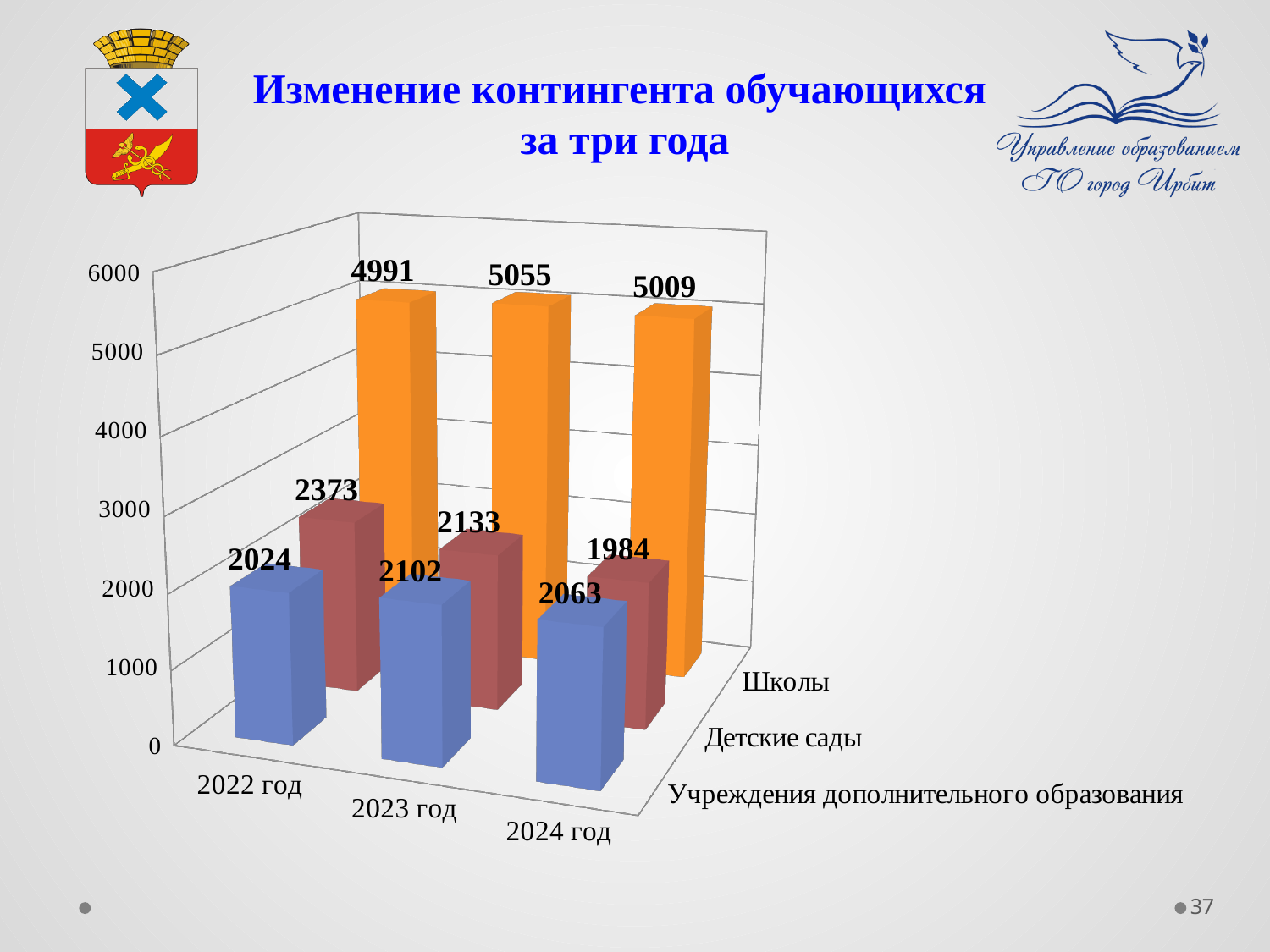
What kind of chart is shown on the slide? bar chart Do the values for Детские сады rise or fall from 2022 год to 2024 год? fall What is the value for Учреждения дополнительного образования in 2022 год? 2024 Which is larger in 2023 год: Детские сады or Учреждения дополнительного образования? Детские сады In which year is the value for Школы the highest? 2023 год In which year is the value for Детские сады the lowest? 2024 год Is the value for Школы in 2022 год greater or less than 4000? greater What is the value for Детские сады in 2024 год? 1984 What is the difference between the Детские сады values for 2022 год and 2024 год? 389 What is the value for Школы in 2023 год? 5055 How many series does the chart show? 3 How many years are shown on the x axis? 3